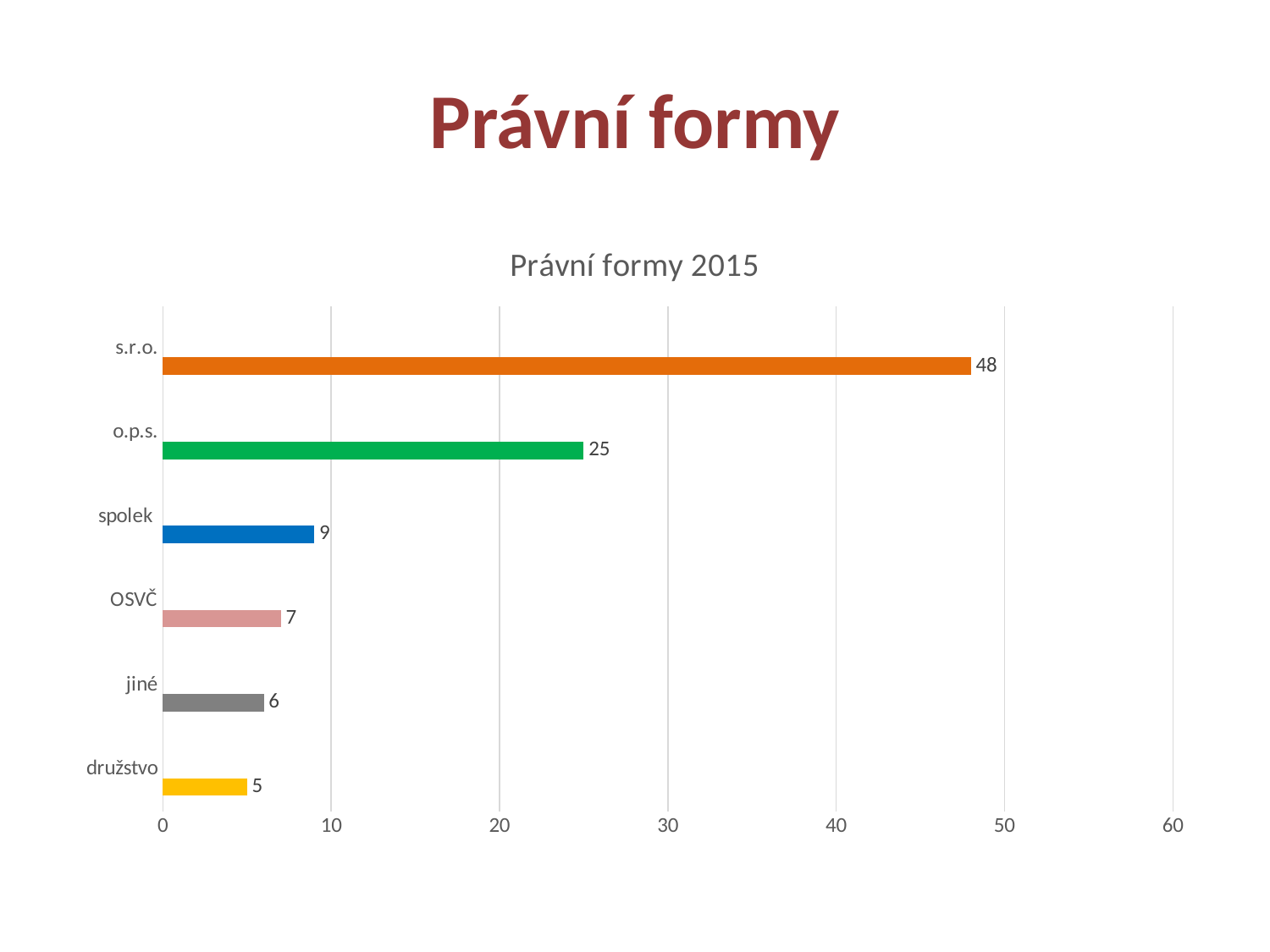
Which category has the lowest value? družstvo What is the value for družstvo? 5 What is the difference between the values for s.r.o. and o.p.s.? 23 What is the value for o.p.s.? 25 What is the value for spolek? 9 Is the value for o.p.s. greater or less than 20? greater What is the title of the chart? Právní formy 2015 Which category has the highest value? s.r.o. What kind of chart is shown on the slide? bar chart What is the value for s.r.o.? 48 Which is larger, the value for OSVČ or the value for jiné? OSVČ How many categories are shown in the chart? 6